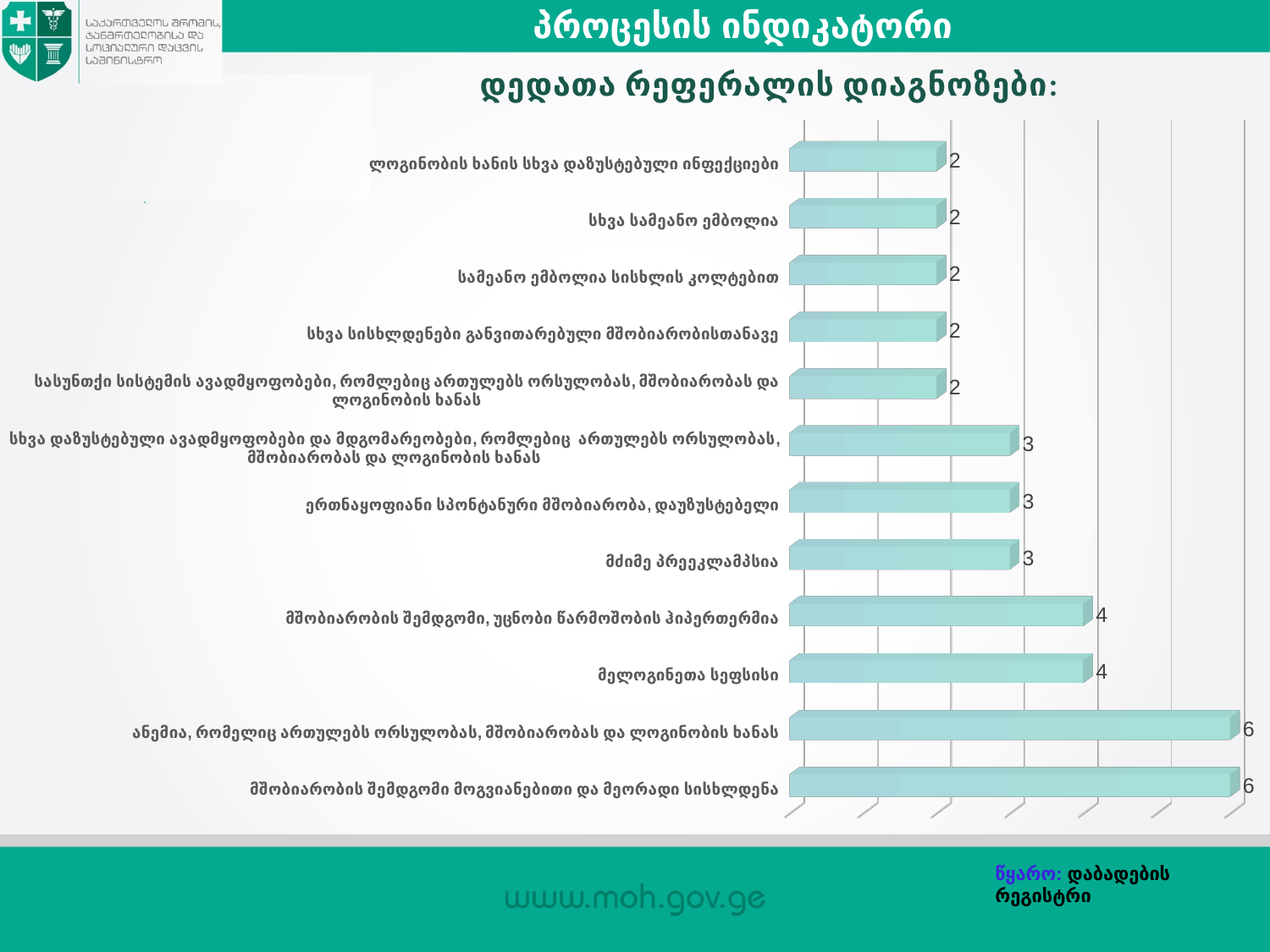
What is the highest value shown in the chart? 6 What is the value for სხვა სამეანო ემბოლია? 2 What is the difference between the value for ანემია, რომელიც ართულებს ორსულობას, მშობიარობას და ლოგინობის ხანას and the value for მძიმე პრეეკლამფსია? 3 What is the value for ანემია, რომელიც ართულებს ორსულობას, მშობიარობას და ლოგინობის ხანას? 6 What is the lowest value shown in the chart? 2 Which has a larger value: მელოგინეთა სეფსისი or სხვა სამეანო ემბოლია? მელოგინეთა სეფსისი What is the title of the chart? დედათა რეფერალის დიაგნოზები: What is the value for მელოგინეთა სეფსისი? 4 What type of chart is shown on the slide? bar chart How many categories (bars) are shown in the chart? 12 What is the value for ერთნაყოფიანი სპონტანური მშობიარობა, დაუზუსტებელი? 3 What is the value for მძიმე პრეეკლამფსია? 3